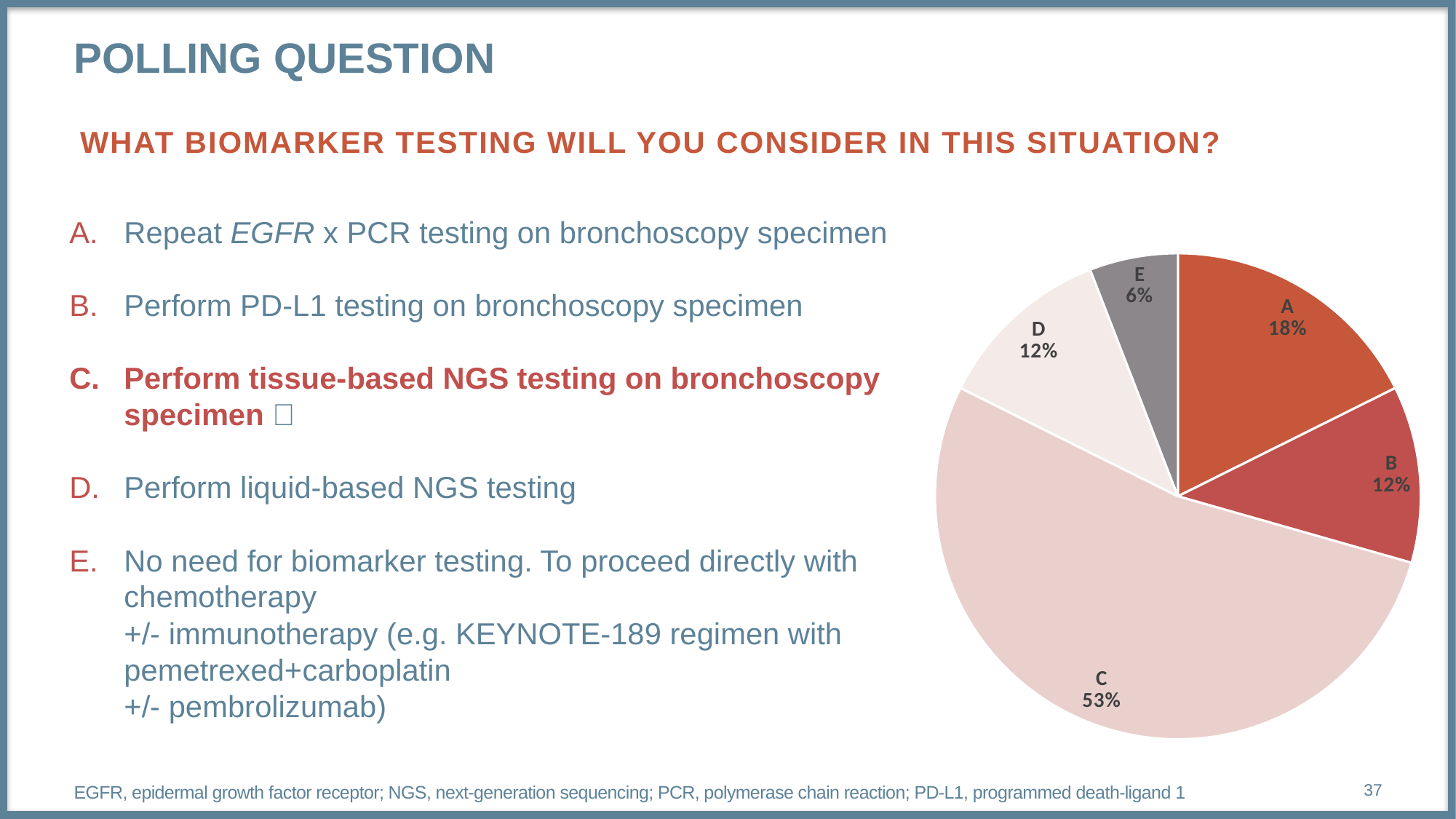
What percentage of respondents chose option A? 18% How many slices does the pie chart have? 5 Which option received the smallest share of responses? E Which slice of the pie chart is grey? E What is the difference in percentage points between option C and option A? 35 What type of chart is shown on the slide? pie chart What is the combined percentage for options A and B? 30% What percentage of respondents chose option E? 6% Which two options received the same percentage of responses? B and D Which received a larger share of responses, option A or option B? A Which option received the largest share of responses? C What percentage of respondents chose option C? 53%